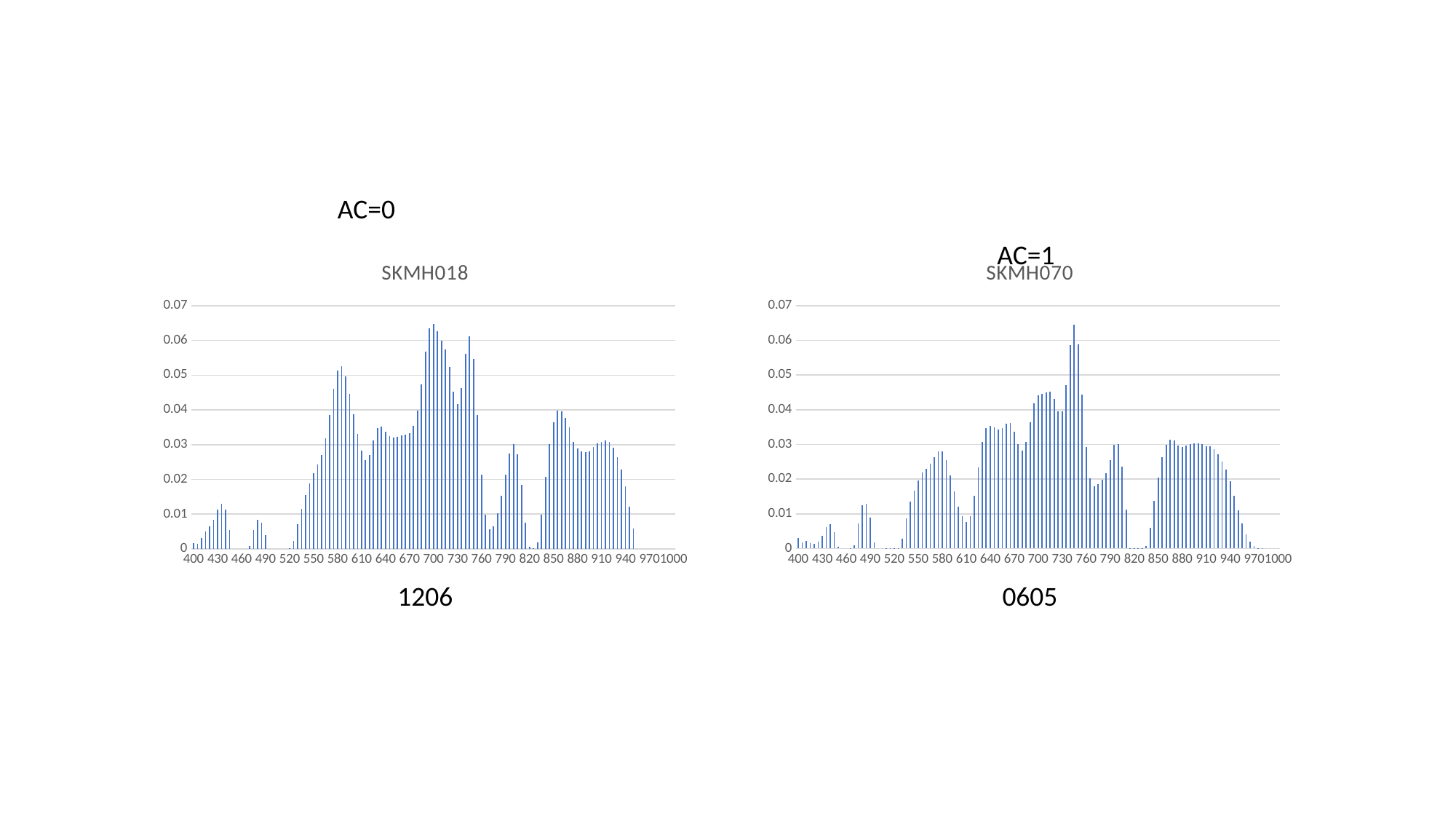
In the SKMH018 chart, is the value at 700 greater or less than 0.06? greater What is the title of the right chart, labelled AC=1? SKMH070 In the SKMH070 chart, is the value at 1000 greater or less than 0.01? less In the SKMH018 chart, is the value at 430 greater or less than 0.02? less What kind of chart is the left chart titled SKMH018? bar chart What is the title of the left chart, labelled AC=0? SKMH018